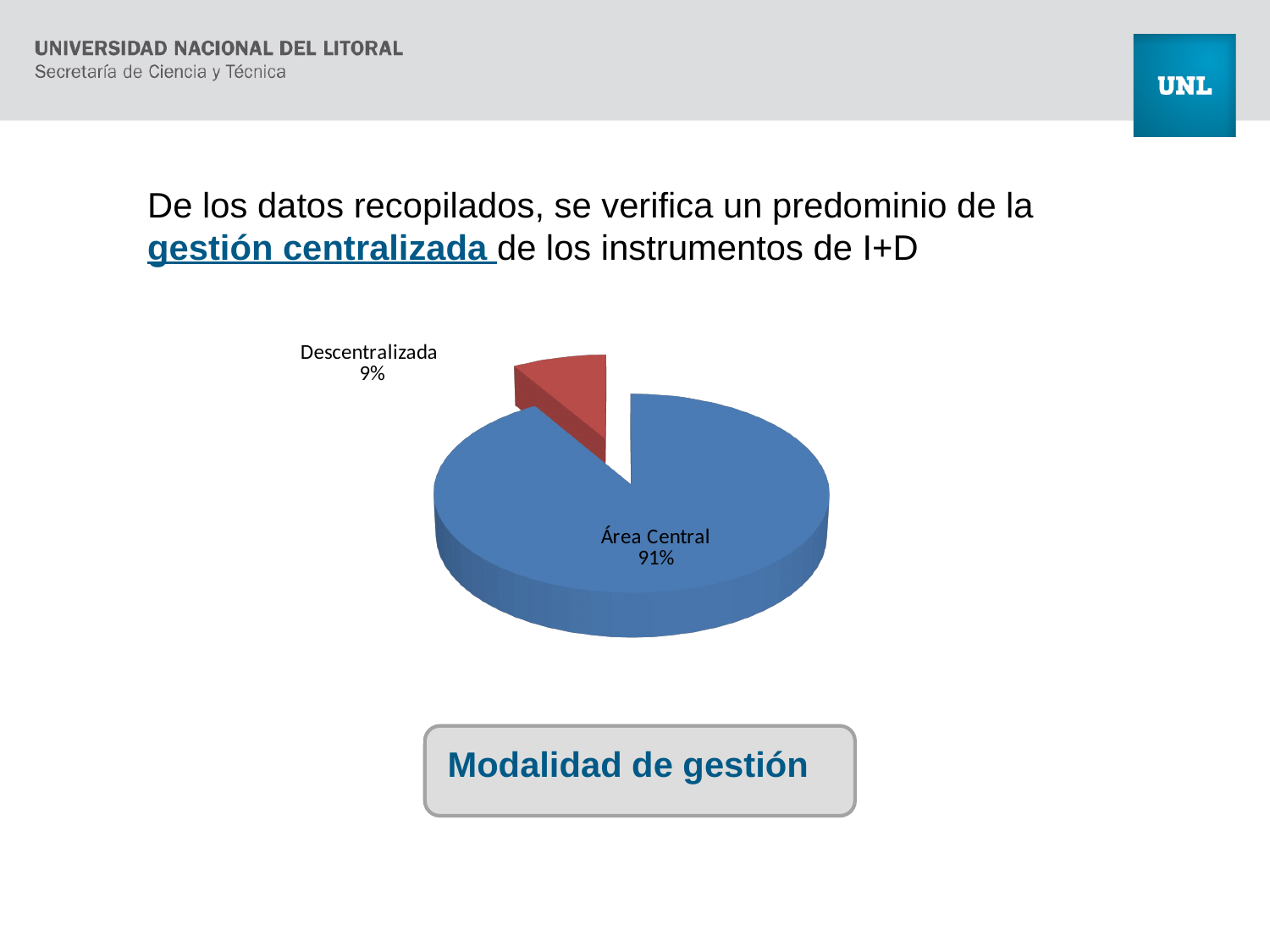
What colour is the Descentralizada slice? Red What share of the pie does Área Central represent? 91% Which is larger, Área Central or Descentralizada? Área Central What share of the pie does Descentralizada represent? 9% What is the label in the box below the chart? Modalidad de gestión Which slice of the pie is the smallest? Descentralizada What kind of chart is shown on the slide? Pie chart What is the difference in percentage points between Área Central and Descentralizada? 82 Which slice of the pie is the largest? Área Central How many slices does the pie chart have? 2